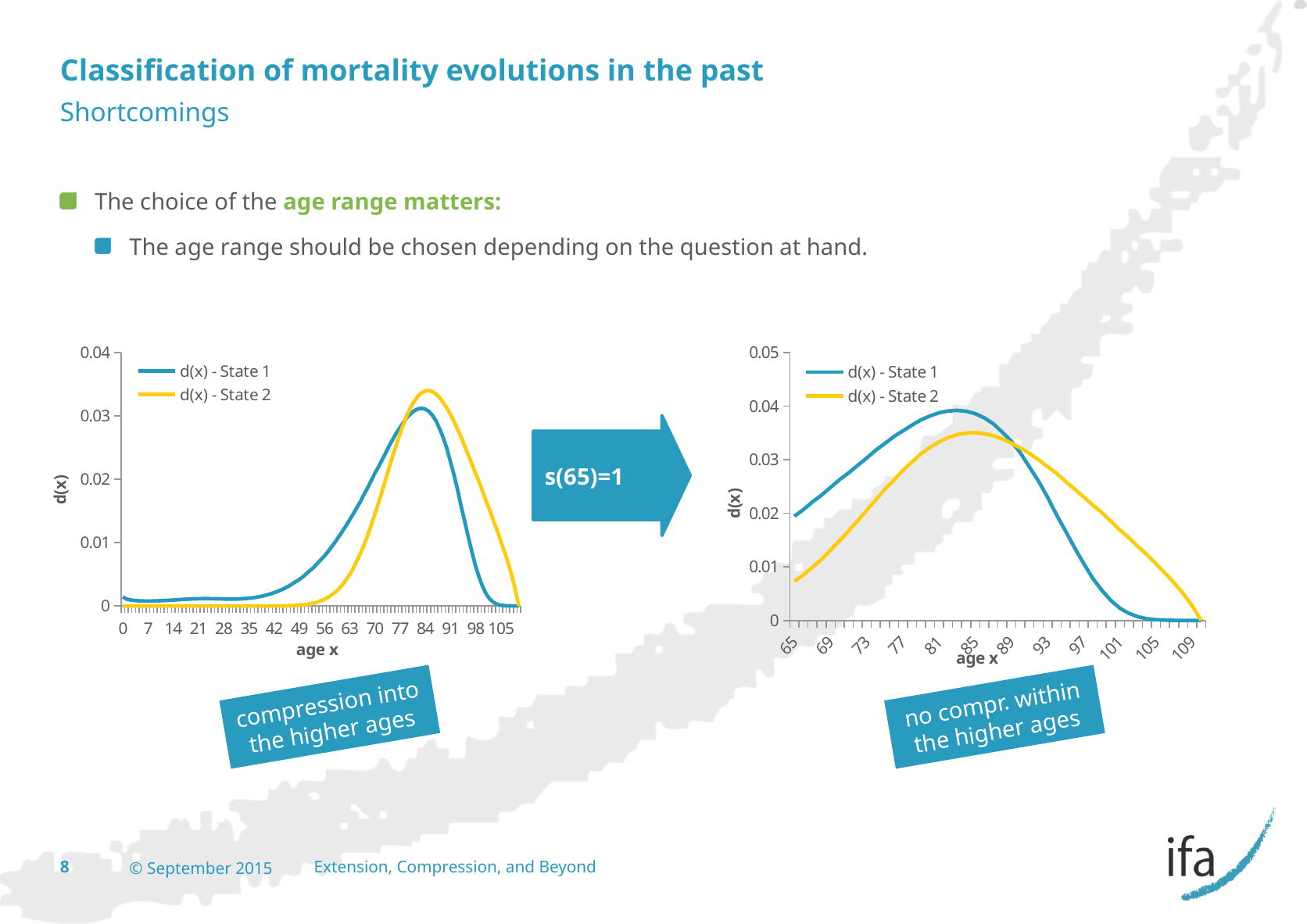
In the right chart, is the peak value of d(x) - State 1 greater or less than 0.03? greater In the left chart, does the d(x) - State 2 series rise or fall between age 91 and age 105? fall In the right chart, which series reaches the higher peak value, d(x) - State 1 or d(x) - State 2? d(x) - State 1 In the right chart, does the d(x) - State 1 series rise or fall between age 65 and age 81? rise In the left chart, is the peak value of d(x) - State 2 greater or less than 0.03? greater What is the label of the x axis on the left chart? age x What are the two legend entries of the left chart? d(x) - State 1 and d(x) - State 2 What kind of chart is the left chart on the slide? line chart In the left chart, which series reaches the higher peak value, d(x) - State 1 or d(x) - State 2? d(x) - State 2 How many series does the legend of the right chart list? 2 In the right chart, is the value of d(x) - State 1 at age 65 greater or less than 0.01? greater